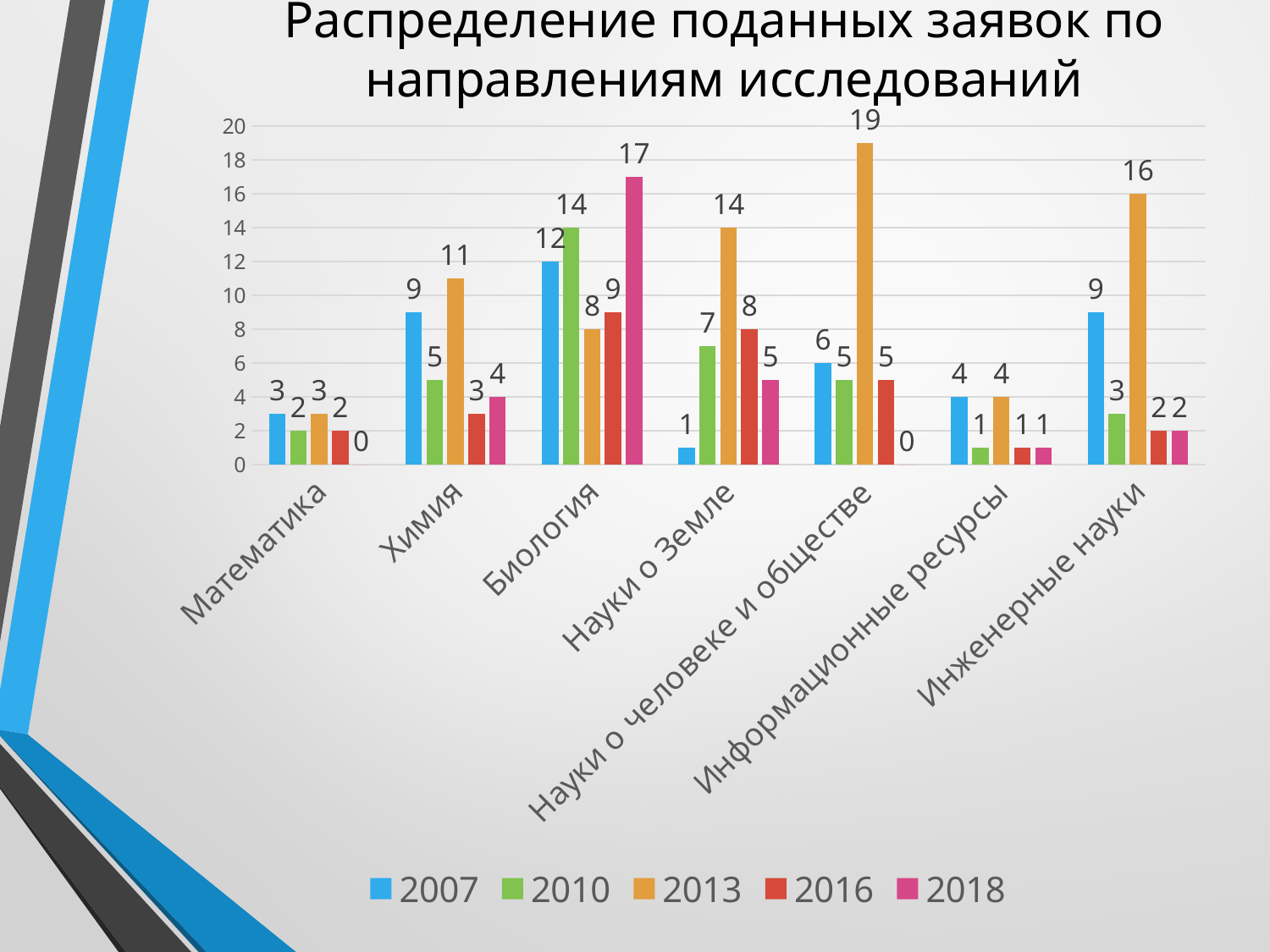
What is the value for Науки о человеке и обществе in the 2013 series? 19 Which is larger for Химия: the 2007 value or the 2013 value? 2013 Which category has the highest value in the 2013 series? Науки о человеке и обществе What is the value for Инженерные науки in the 2013 series? 16 How many categories are shown on the x axis? 7 What is the value for Биология in the 2018 series? 17 What is the difference between the 2013 and 2007 values for Инженерные науки? 7 What is the title of the chart? Распределение поданных заявок по направлениям исследований What kind of chart is shown on the slide? Bar chart Which category has the lowest value in the 2010 series? Информационные ресурсы What is the value for Науки о Земле in the 2007 series? 1 How many series does the legend list? 5